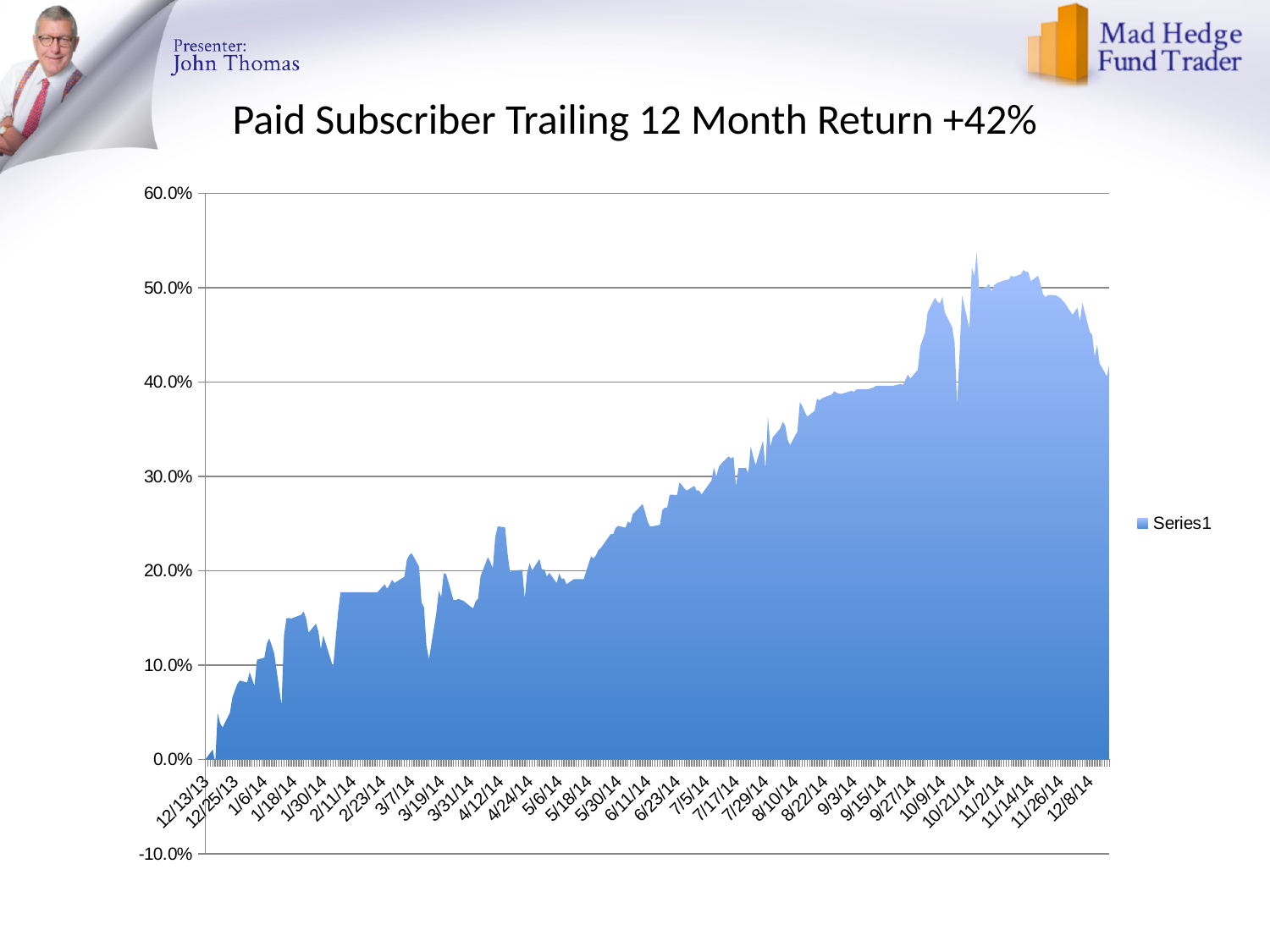
Which is larger, the value for 10/21/14 or the value for 3/7/14? 10/21/14 How many series does the legend list? 1 What is the title of the chart? Paid Subscriber Trailing 12 Month Return +42% Overall, do the values rise or fall from the left of the x axis to the right? Rise What is the name of the series shown in the legend? Series1 Around which date does the series reach its highest value? 10/21/14 What kind of chart is shown on the slide? Area chart Is the value for 9/3/14 greater or less than 40%? less Is the value for 12/13/13 greater or less than 10%? less Is the value for 12/8/14 greater or less than 40%? greater